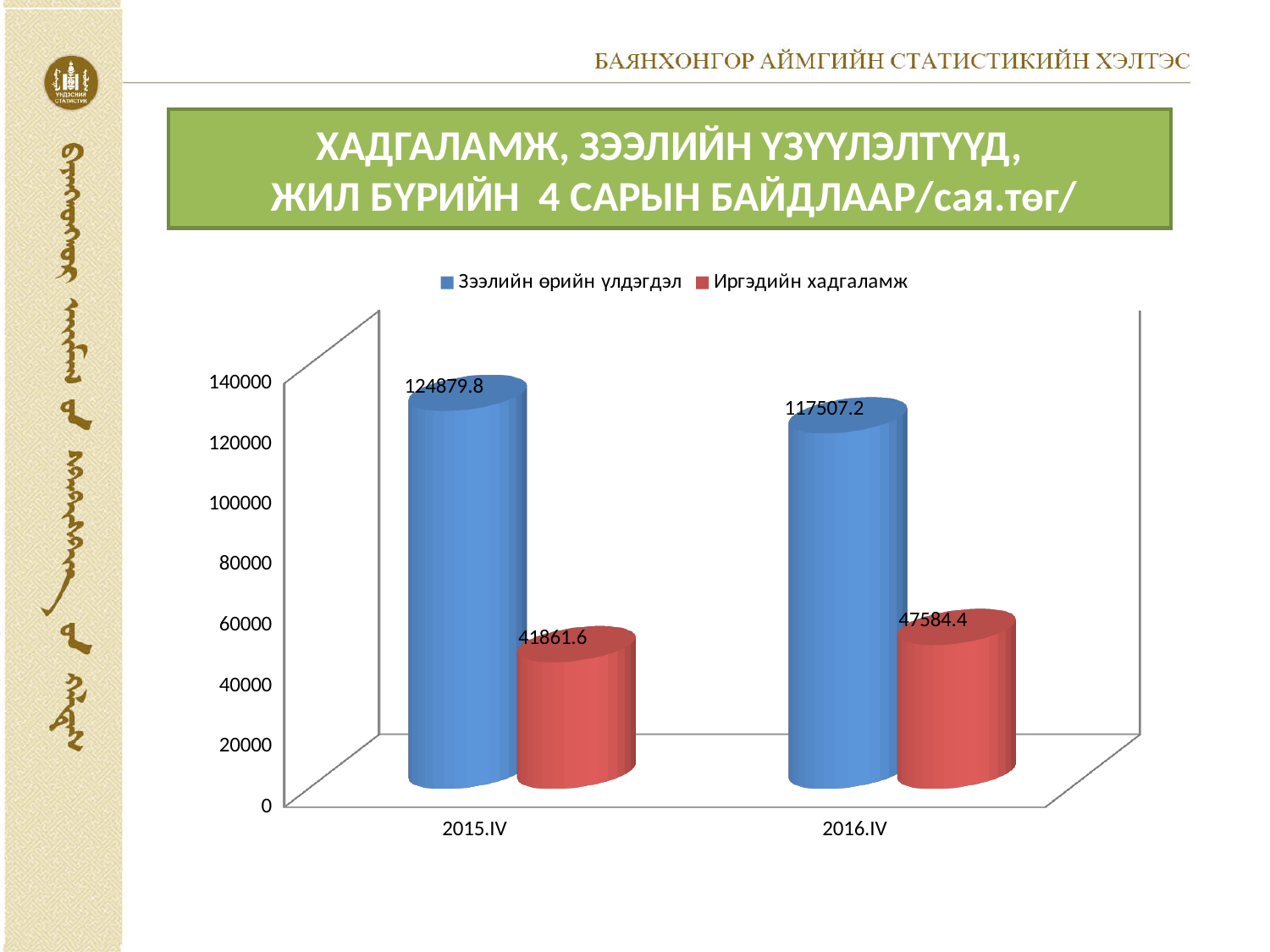
What is the value of Иргэдийн хадгаламж for 2016.IV? 47584.4 Which is larger in 2016.IV: Зээлийн өрийн үлдэгдэл or Иргэдийн хадгаламж? Зээлийн өрийн үлдэгдэл How many series does the legend list? 2 What kind of chart is shown on the slide? Bar chart What is the value of Иргэдийн хадгаламж for 2015.IV? 41861.6 Does Иргэдийн хадгаламж rise or fall from 2015.IV to 2016.IV? Rise In which period is Зээлийн өрийн үлдэгдэл highest? 2015.IV What is the value of Зээлийн өрийн үлдэгдэл for 2016.IV? 117507.2 What is the value of Зээлийн өрийн үлдэгдэл for 2015.IV? 124879.8 By how much did Зээлийн өрийн үлдэгдэл decrease from 2015.IV to 2016.IV? 7372.6 What is the difference between Иргэдийн хадгаламж in 2016.IV and 2015.IV? 5722.8 In which period is Иргэдийн хадгаламж lowest? 2015.IV